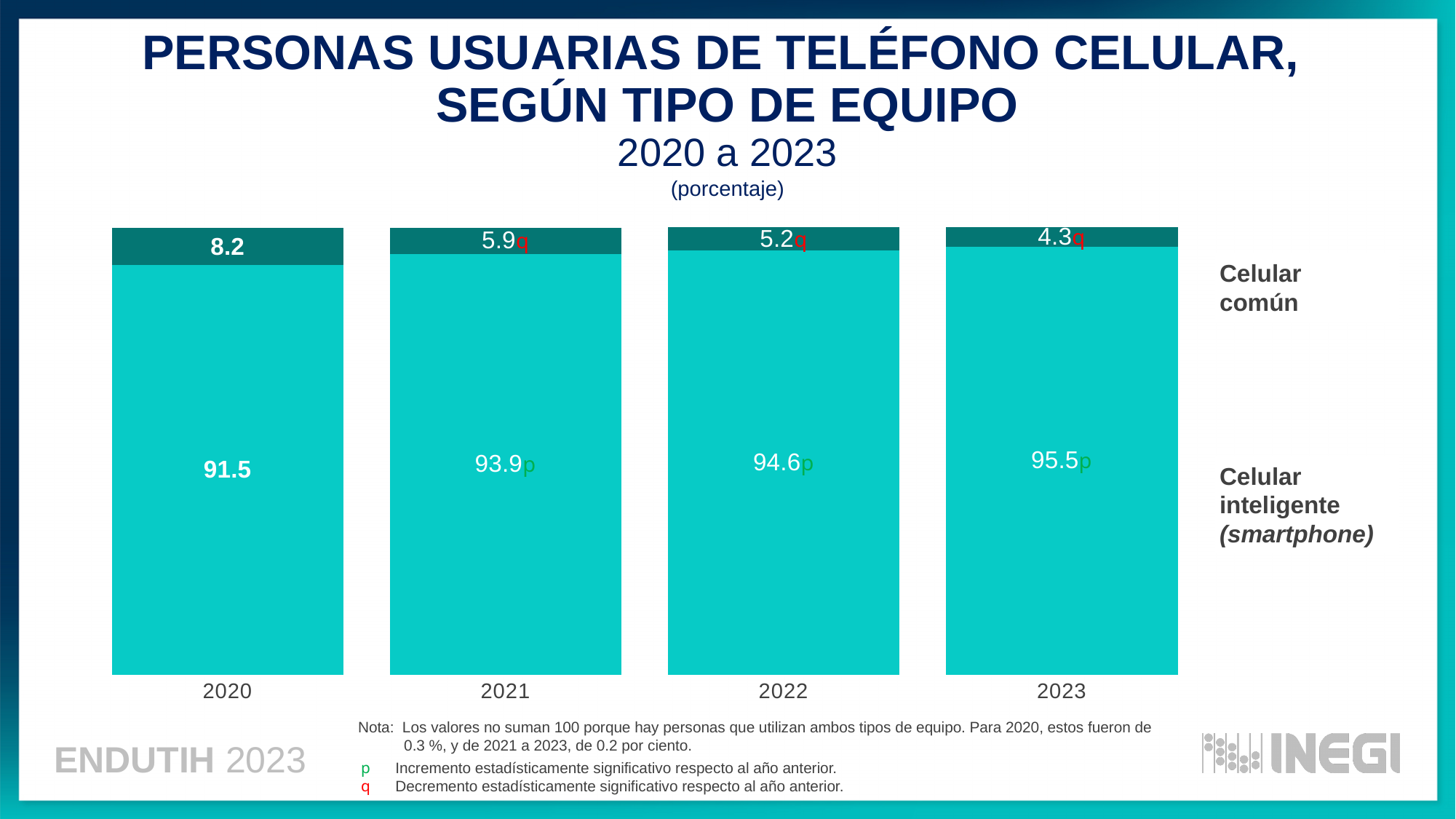
What is the value for Celular inteligente (smartphone) in 2023? 95.5 In which year is the Celular común value lowest? 2023 How many series does the chart show? 2 What is the difference between the Celular común values for 2020 and 2021? 2.3 What is the value for Celular común in 2020? 8.2 How many years are shown on the x axis? 4 What kind of chart is shown on the slide? Stacked bar chart In which year is the Celular inteligente (smartphone) value highest? 2023 What is the value for Celular común in 2022? 5.2 Does the Celular común value rise or fall from 2020 to 2023? Fall What is the difference between the Celular inteligente (smartphone) values for 2023 and 2020? 4.0 Which is larger, the Celular común value for 2021 or for 2023? 2021